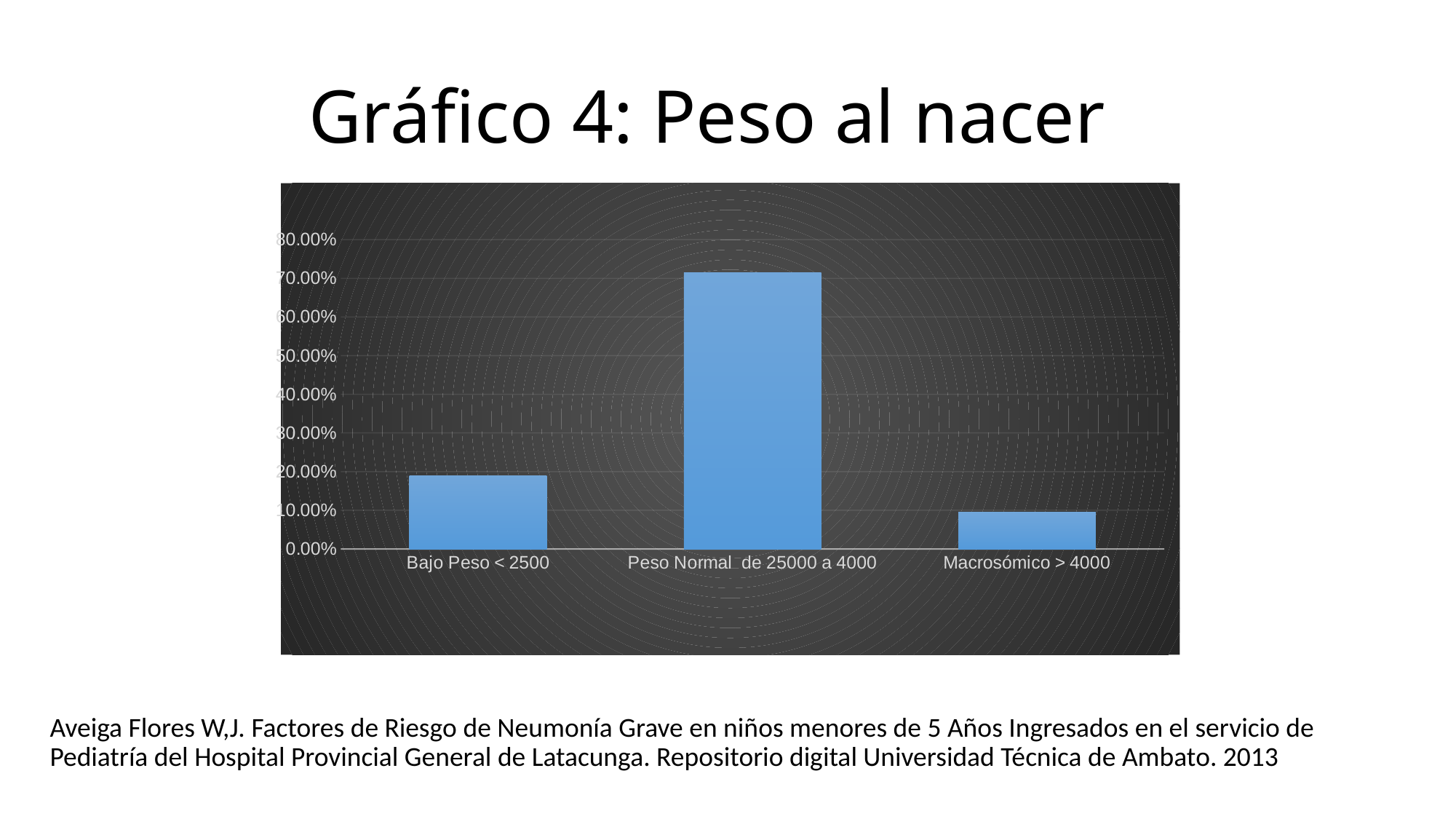
What colour are the bars in the chart? blue Which category has the lowest value in the chart? Macrosómico > 4000 Is the value for Bajo Peso < 2500 greater or less than 30.00%? less Is the value for Peso Normal de 25000 a 4000 greater or less than 60.00%? greater What is the title of the chart on the slide? Gráfico 4: Peso al nacer Is the value for Peso Normal de 25000 a 4000 greater or less than 80.00%? less What kind of chart is shown on the slide? bar chart Which category has the highest value in the chart? Peso Normal de 25000 a 4000 How many categories are shown on the x axis of the chart? 3 Which is larger, the value for Bajo Peso < 2500 or the value for Macrosómico > 4000? Bajo Peso < 2500